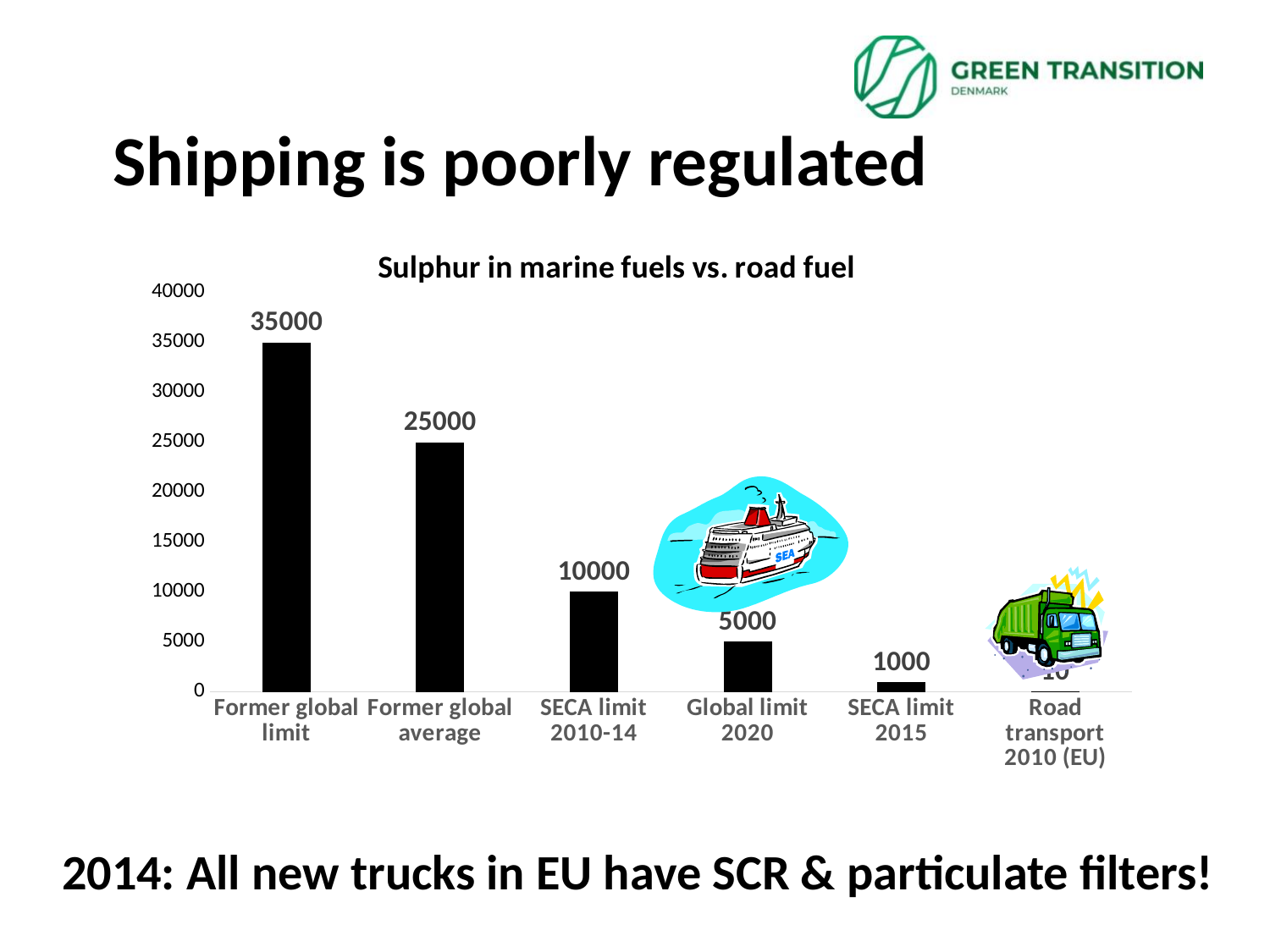
Which category has the lowest value? Road transport 2010 (EU) What is the value for Global limit 2020? 5000 Which category has the highest value? Former global limit What kind of chart is this? Bar chart How many categories are shown on the chart? 6 Which is larger, SECA limit 2010-14 or Global limit 2020? SECA limit 2010-14 What is the title of the chart? Sulphur in marine fuels vs. road fuel What is the value for Former global average? 25000 What is the difference between Former global limit and Former global average? 10000 What is the value for SECA limit 2015? 1000 What is the value for Former global limit? 35000 What is the value for SECA limit 2010-14? 10000